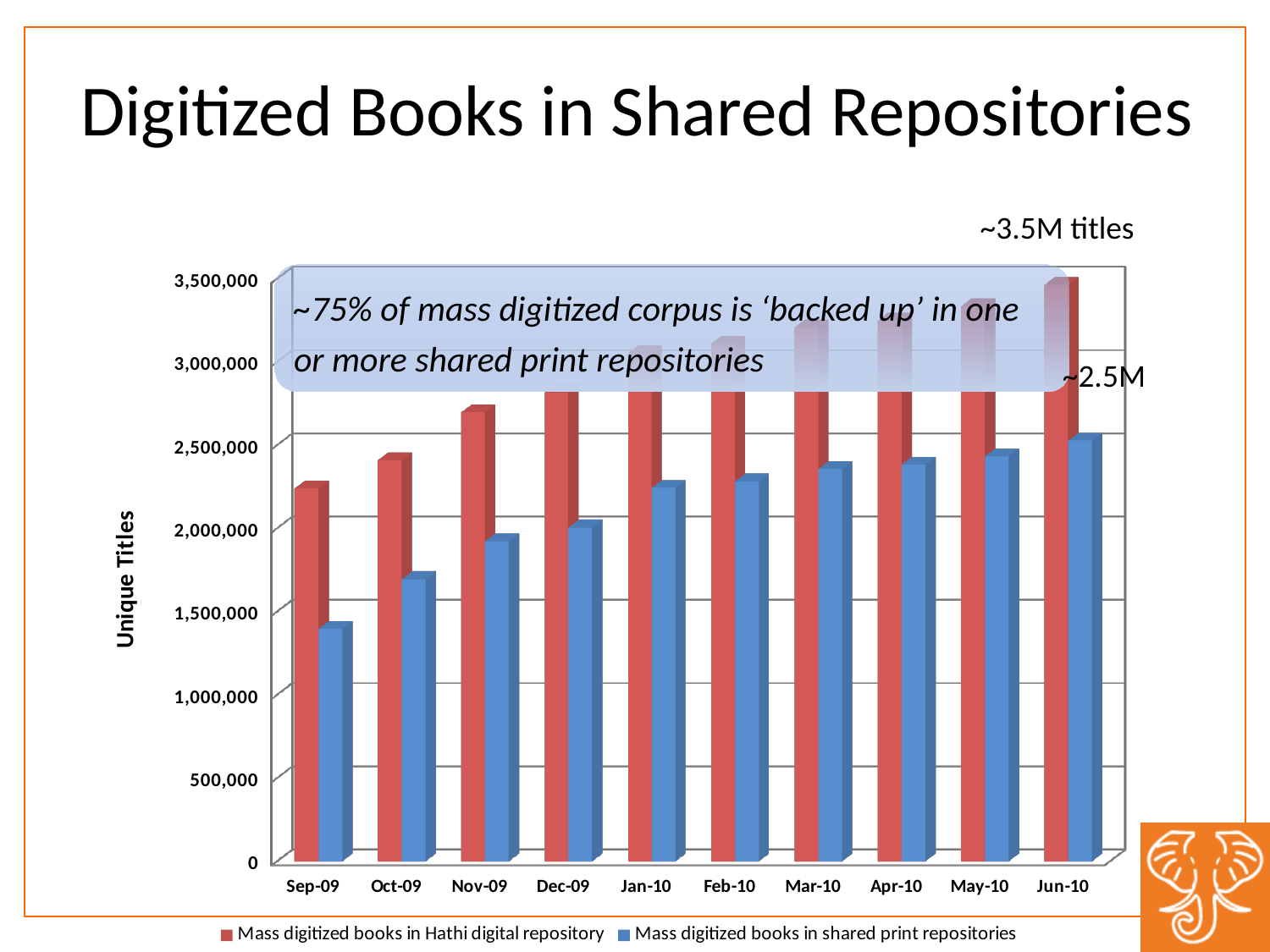
Is the value for mass digitized books in Hathi digital repository in Jun-10 greater or less than 3,000,000? greater Is the value for mass digitized books in shared print repositories in Oct-09 greater or less than 2,000,000? less How many months are shown along the x axis of the chart? 10 Which month has the lowest value for mass digitized books in shared print repositories? Sep-09 Is the value for mass digitized books in Hathi digital repository in Sep-09 greater or less than 2,000,000? greater In Sep-09, which is larger: mass digitized books in Hathi digital repository or mass digitized books in shared print repositories? Mass digitized books in Hathi digital repository Which month has the highest value for mass digitized books in Hathi digital repository? Jun-10 What is the title of the chart's vertical axis? Unique Titles Do the values for mass digitized books in shared print repositories rise or fall from Sep-09 to Jun-10? Rise How many series does the chart's legend list? 2 What kind of chart is shown on the slide? Bar chart